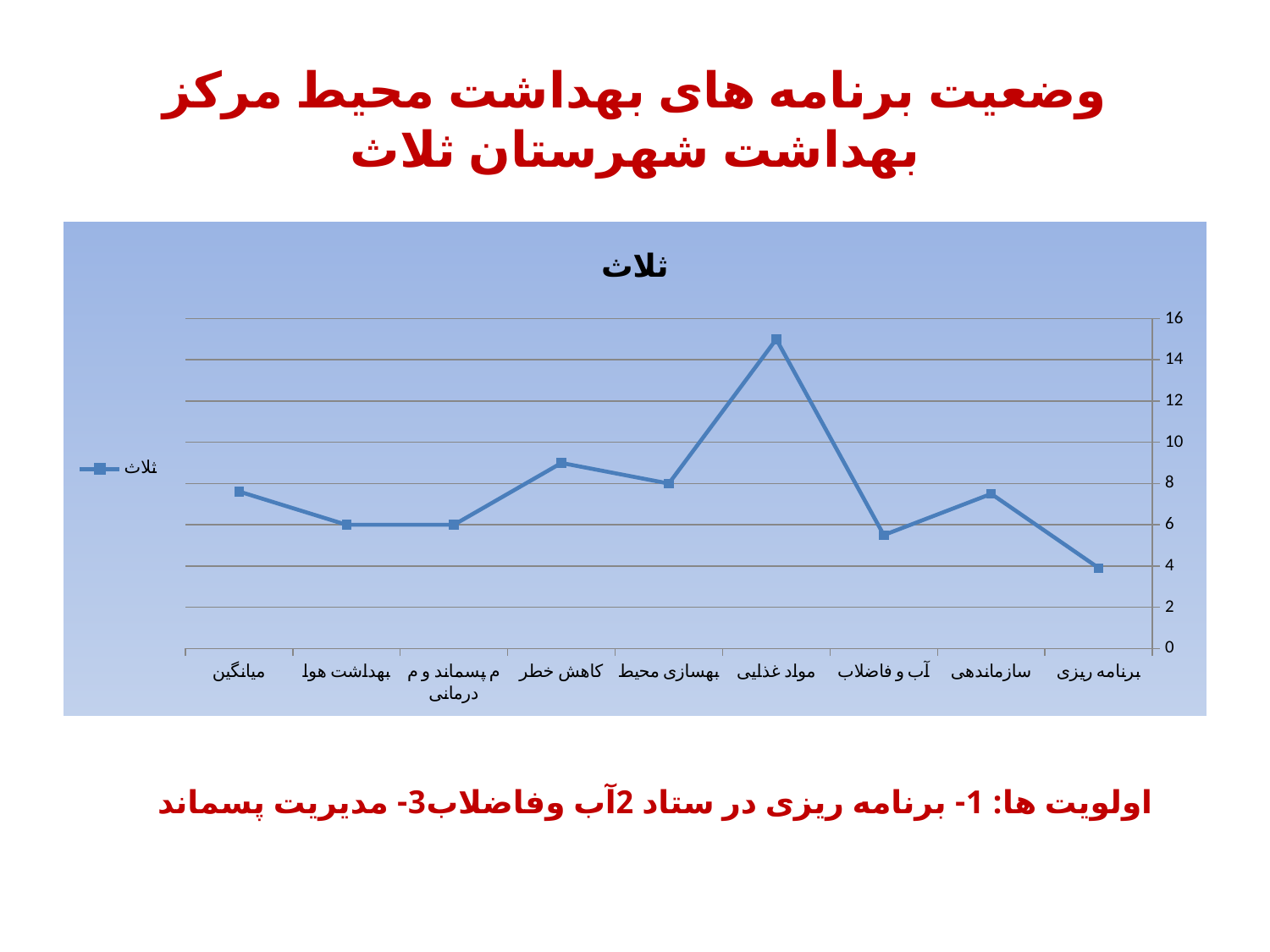
Which category has the highest value? مولد غذایی What is the value for بهداشت هوا? 6 What is the title of the chart? ثلاث How many series does the legend list? 1 Which category has the lowest value? برنامه ریزی Is the value for مولد غذایی greater or less than 14? greater What kind of chart is shown on the slide? line chart What is the value for بهسازی محیط? 8 Is the value for کاهش خطر greater or less than 8? greater Is the value for آب و فاضلاب greater or less than 6? less How many categories are plotted along the x axis? 9 Which is larger, the value for سازماندهی or the value for آب و فاضلاب? سازماندهی